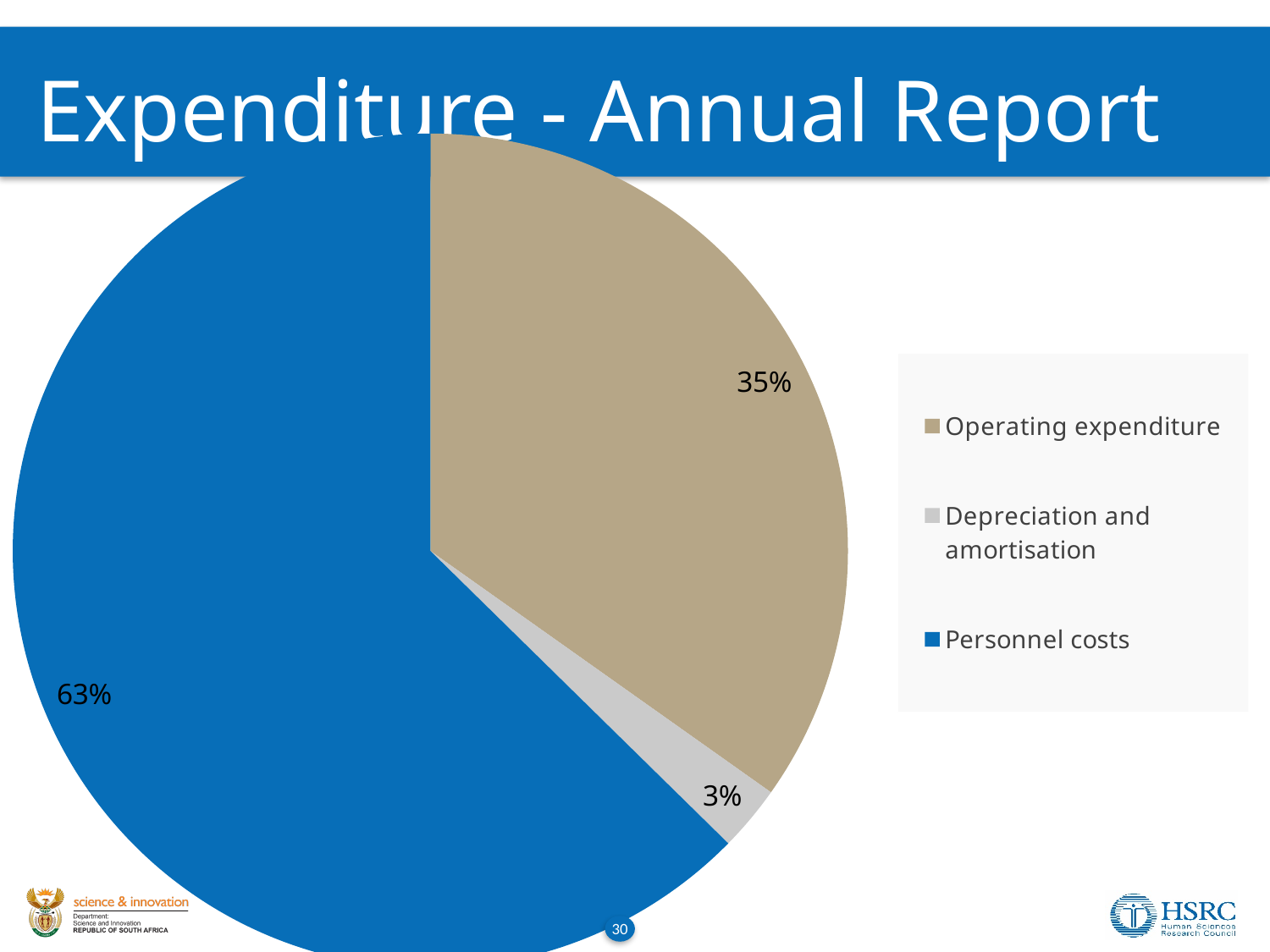
What is the difference in percentage points between Operating expenditure and Depreciation and amortisation? 32 What share of expenditure is Personnel costs? 63% Which is larger, Operating expenditure or Depreciation and amortisation? Operating expenditure How many categories does the pie chart show? 3 What is the title of the slide? Expenditure - Annual Report What share of expenditure is Operating expenditure? 35% What share of expenditure is Depreciation and amortisation? 3% What colour is the Personnel costs slice? Blue Which category has the smallest share of expenditure? Depreciation and amortisation What is the difference in percentage points between Personnel costs and Operating expenditure? 28 What kind of chart is shown on the slide? Pie chart Which category has the largest share of expenditure? Personnel costs